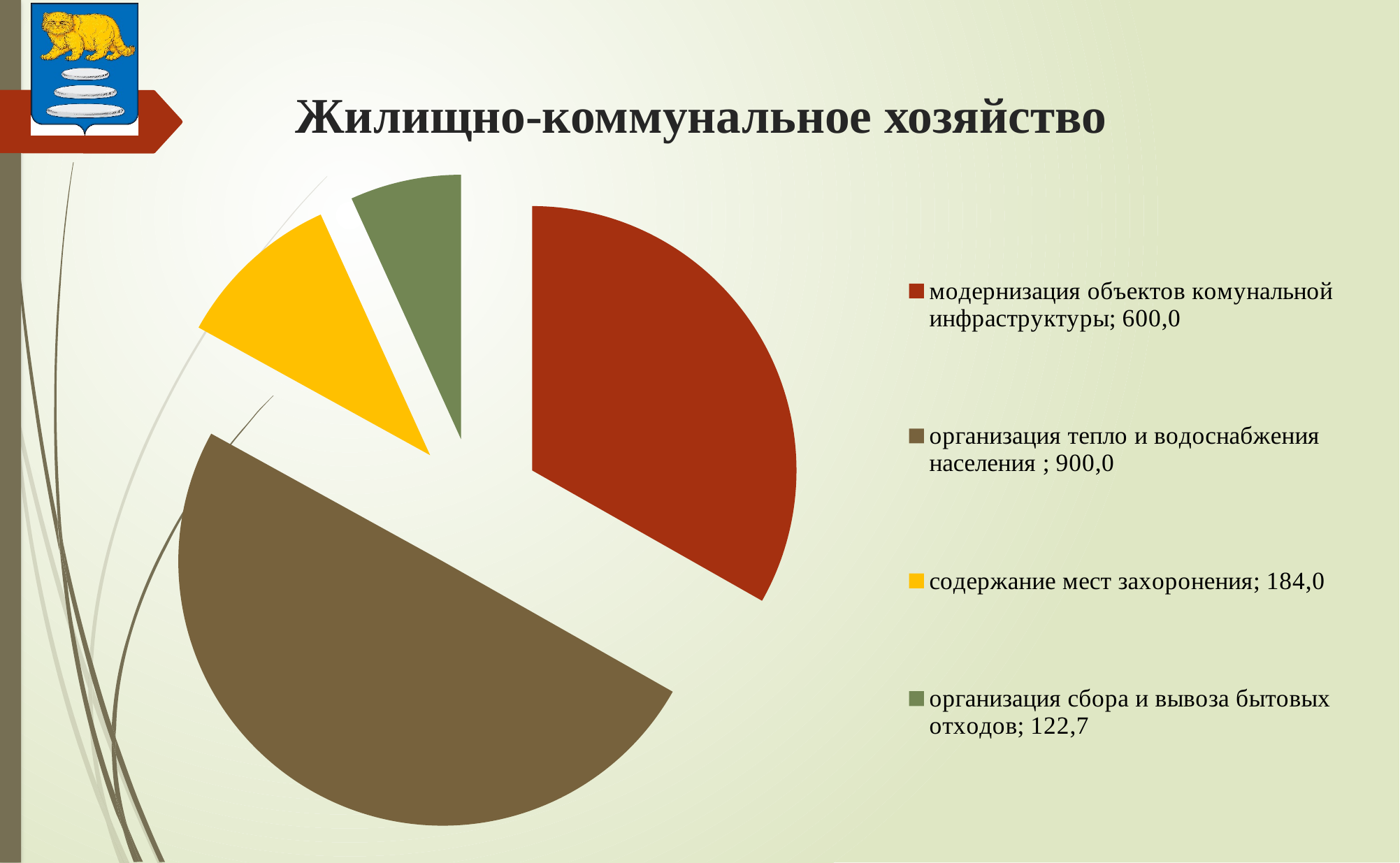
What type of chart is shown on the slide? pie chart What is the difference between the values for "организация тепло и водоснабжения населения" and "модернизация объектов комунальной инфраструктуры"? 300,0 What is the value for "модернизация объектов комунальной инфраструктуры"? 600,0 Which category has the largest value? организация тепло и водоснабжения населения How many slices does the pie chart have? 4 Which is larger: the value for "содержание мест захоронения" or for "организация сбора и вывоза бытовых отходов"? содержание мест захоронения Which category has the smallest value? организация сбора и вывоза бытовых отходов What is the difference between the values for "содержание мест захоронения" and "организация сбора и вывоза бытовых отходов"? 61,3 What is the value for "организация сбора и вывоза бытовых отходов"? 122,7 What is the value for "содержание мест захоронения"? 184,0 What is the title of the slide containing the pie chart? Жилищно-коммунальное хозяйство What is the value for "организация тепло и водоснабжения населения"? 900,0